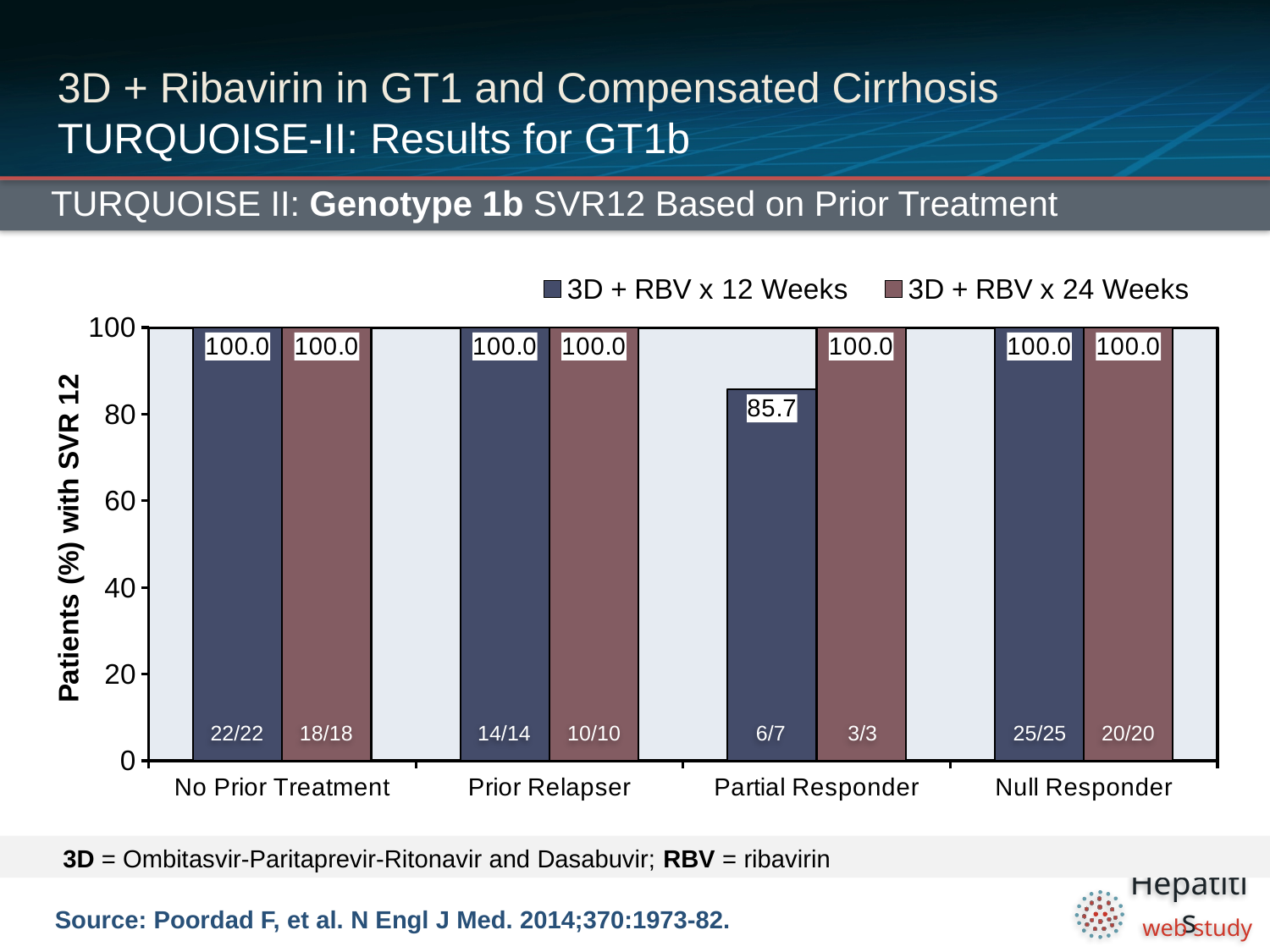
In the Partial Responder category, which series has the larger value, 3D + RBV x 12 Weeks or 3D + RBV x 24 Weeks? 3D + RBV x 24 Weeks Is the value for 3D + RBV x 12 Weeks in the Partial Responder category greater or less than 80? greater What is the difference between the 3D + RBV x 24 Weeks and 3D + RBV x 12 Weeks values in the Partial Responder category? 14.3 What fraction of patients is shown for the 3D + RBV x 24 Weeks bar in the Prior Relapser category? 10/10 How many series does the legend list? 2 Which category has the lowest value for the 3D + RBV x 12 Weeks series? Partial Responder What fraction of patients is shown for the 3D + RBV x 12 Weeks bar in the No Prior Treatment category? 22/22 How many prior treatment categories are shown on the x axis? 4 What is the label of the y axis? Patients (%) with SVR 12 What is the SVR12 rate for the 3D + RBV x 12 Weeks series in the Partial Responder category? 85.7 What is the SVR12 rate for the 3D + RBV x 24 Weeks series in the Null Responder category? 100.0 What kind of chart is shown on the slide? Bar chart